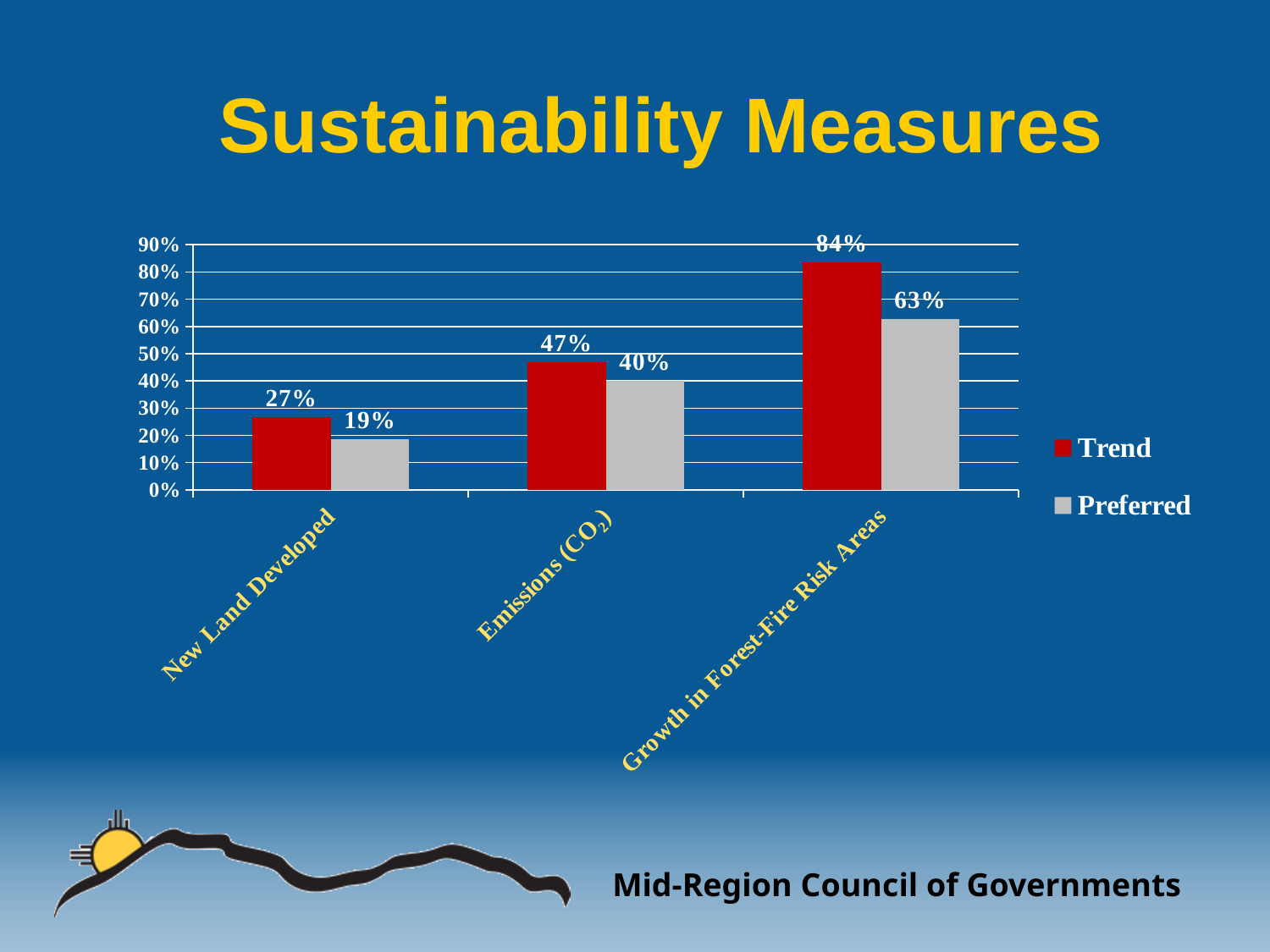
What is the difference between the Trend and Preferred values for New Land Developed? 8% What colour are the Trend bars? Red What is the Trend value for New Land Developed? 27% What is the Trend value for Growth in Forest-Fire Risk Areas? 84% What is the difference between the Trend and Preferred values for Growth in Forest-Fire Risk Areas? 21% Which is larger for Emissions (CO2): the Trend value or the Preferred value? Trend Which category has the lowest Preferred value? New Land Developed What is the Preferred value for Emissions (CO2)? 40% How many series does the legend list? 2 What kind of chart is shown on the slide? Bar chart How many categories are shown on the x axis? 3 Which category has the highest Trend value? Growth in Forest-Fire Risk Areas